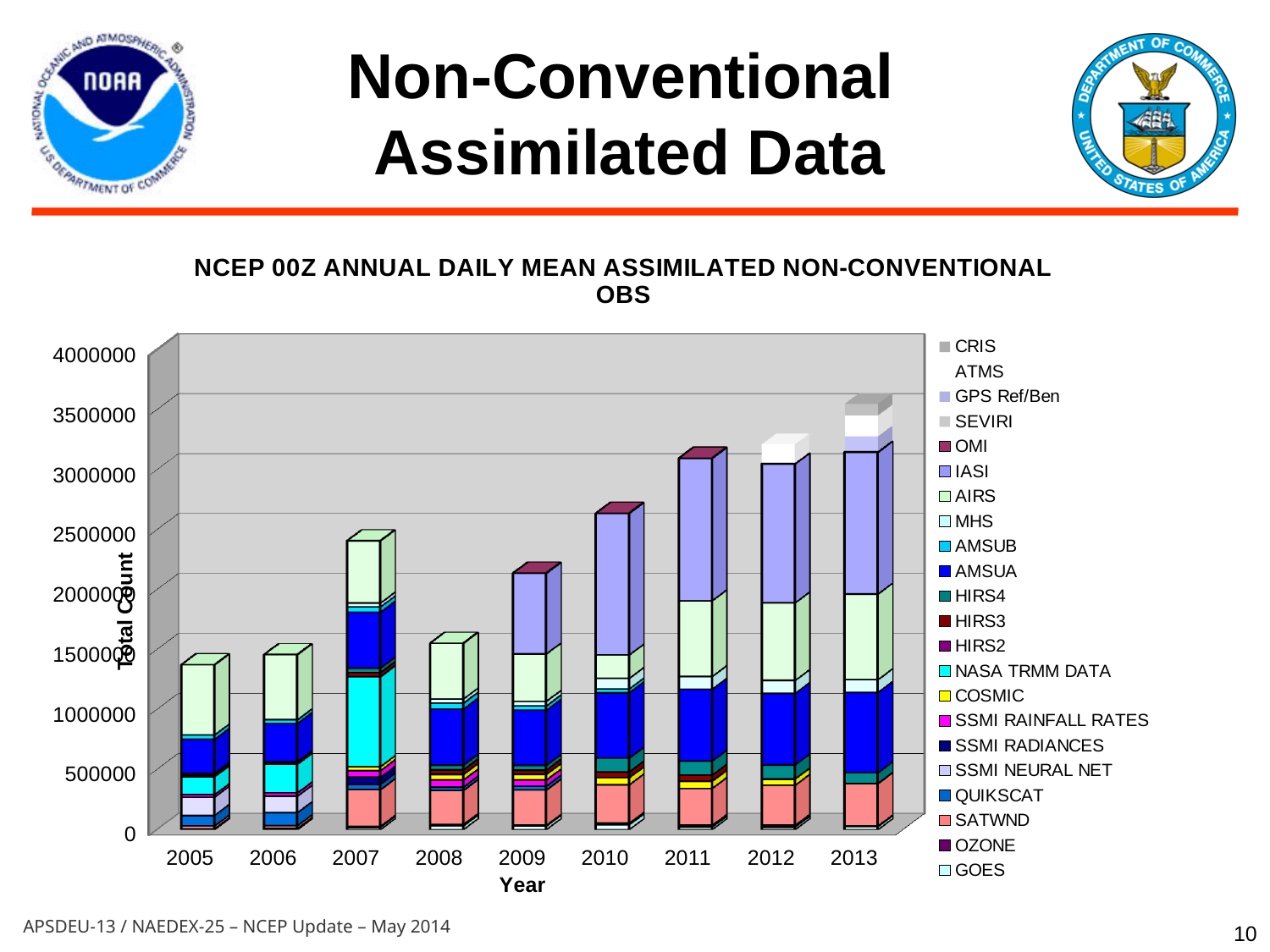
Is the total count for 2013 greater or less than 3000000? greater Overall, does the total count rise or fall from 2005 to 2013? rise What is the label of the chart's vertical axis? Total Count What kind of chart is shown on the slide? Stacked bar chart How many years are shown along the x axis of the chart? 9 Is the total count for 2005 greater or less than 2000000? less Which year has a larger total count, 2009 or 2010? 2010 How many series does the chart's legend list? 22 Which year has the highest total count in the chart? 2013 Which year has a larger total count, 2007 or 2008? 2007 Is the total count for 2009 greater or less than 2500000? less What is the title of the chart? NCEP 00Z ANNUAL DAILY MEAN ASSIMILATED NON-CONVENTIONAL OBS